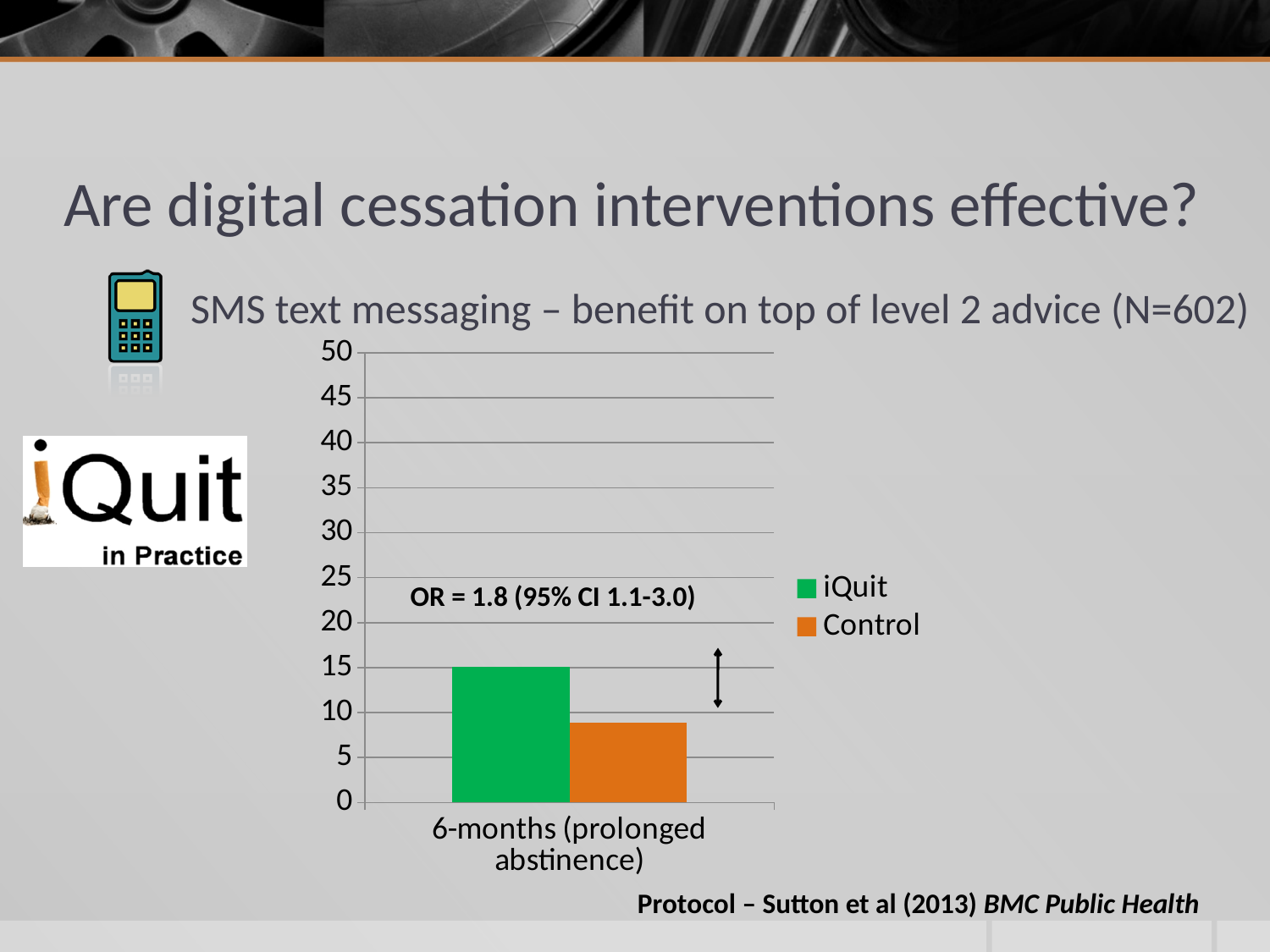
Which series has the higher bar for 6-months (prolonged abstinence), iQuit or Control? iQuit Is the value for Control at 6-months (prolonged abstinence) greater or less than 10? less Is the value for iQuit at 6-months (prolonged abstinence) greater or less than 20? less How many series does the chart legend list? 2 How many categories are shown on the x axis of the chart? 1 Is the value for Control at 6-months (prolonged abstinence) greater or less than 5? greater Which series has the lowest bar in the chart? Control What is the category label on the x axis of the chart? 6-months (prolonged abstinence) What odds ratio is annotated on the chart? OR = 1.8 (95% CI 1.1-3.0) What kind of chart is shown on the slide? bar chart Which series has the highest bar in the chart? iQuit